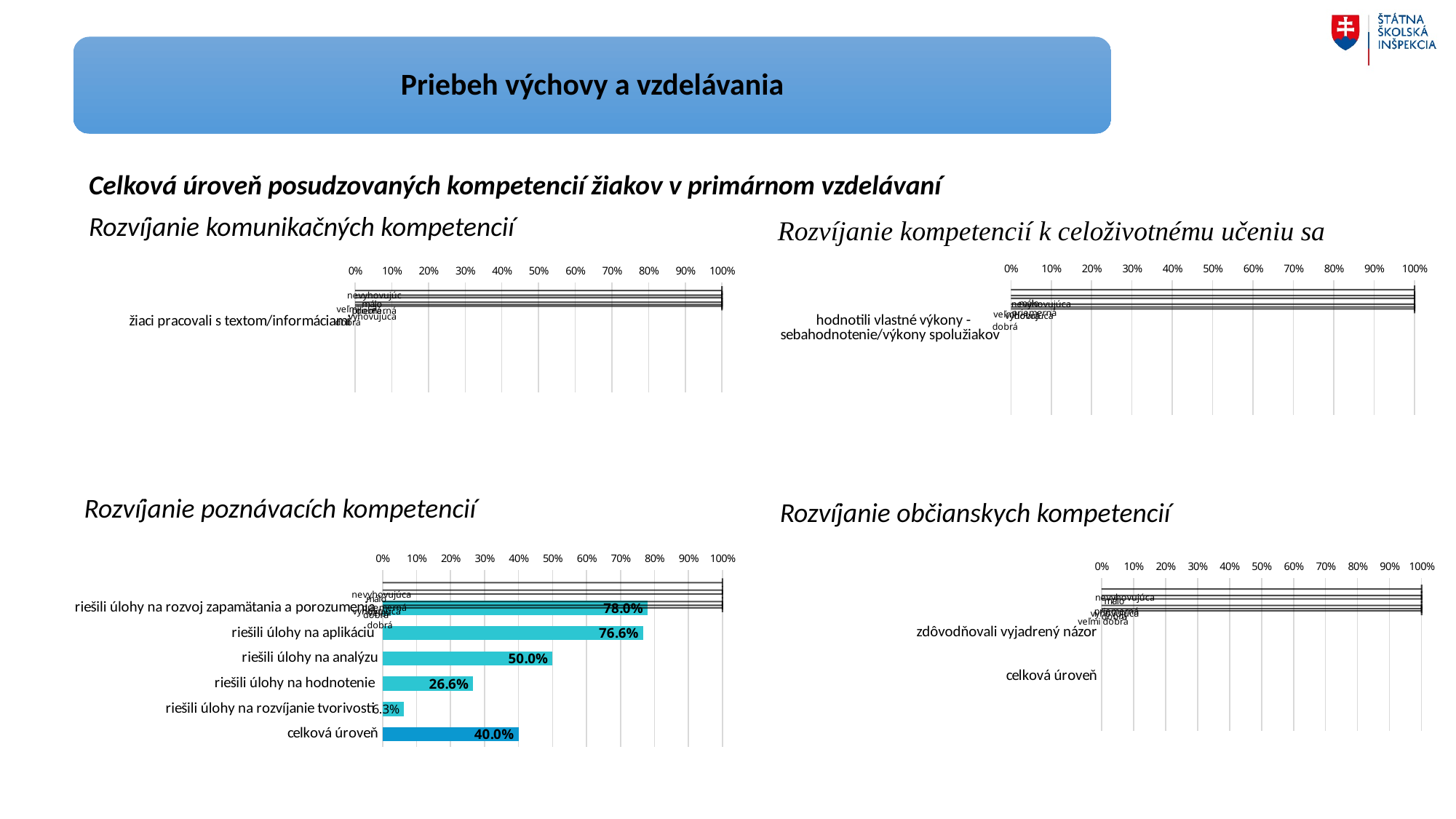
In the chart 'Rozvíjanie poznávacích kompetencií', what is the difference between the values for 'riešili úlohy na rozvoj zapamätania a porozumenia' and 'riešili úlohy na aplikáciu'? 1.4% In the chart 'Rozvíjanie poznávacích kompetencií', how many categories are plotted with bars? 6 In the chart 'Rozvíjanie poznávacích kompetencií', what is the value for 'riešili úlohy na aplikáciu'? 76.6% In the chart 'Rozvíjanie poznávacích kompetencií', what is the value for 'riešili úlohy na hodnotenie'? 26.6% In the chart 'Rozvíjanie poznávacích kompetencií', is the value for 'riešili úlohy na aplikáciu' greater or less than 70%? greater In the chart 'Rozvíjanie poznávacích kompetencií', which category has the highest value? riešili úlohy na rozvoj zapamätania a porozumenia In the chart 'Rozvíjanie poznávacích kompetencií', which category has the lowest value? riešili úlohy na rozvíjanie tvorivosti What kind of chart is 'Rozvíjanie poznávacích kompetencií'? bar chart In the chart 'Rozvíjanie poznávacích kompetencií', what is the difference between the values for 'riešili úlohy na analýzu' and 'riešili úlohy na hodnotenie'? 23.4% In the chart 'Rozvíjanie poznávacích kompetencií', what is the value for 'celková úroveň'? 40.0% In the chart 'Rozvíjanie poznávacích kompetencií', which is larger: the value for 'celková úroveň' or the value for 'riešili úlohy na hodnotenie'? celková úroveň In the chart 'Rozvíjanie poznávacích kompetencií', what is the value for 'riešili úlohy na analýzu'? 50.0%